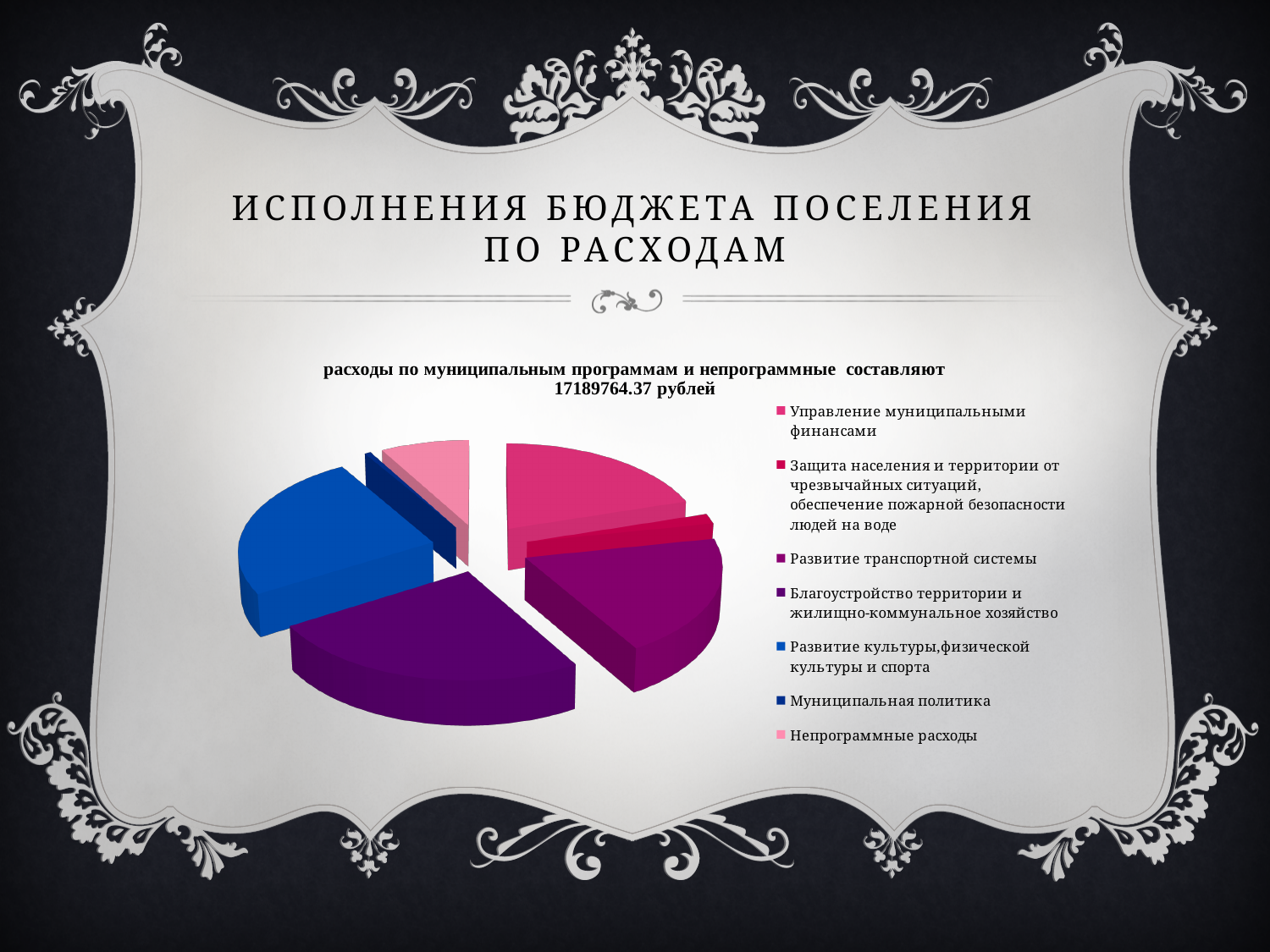
Which slice is larger: "Муниципальная политика" or "Непрограммные расходы"? Непрограммные расходы Which slice is larger: "Управление муниципальными финансами" or "Защита населения и территории от чрезвычайных ситуаций, обеспечение пожарной безопасности людей на воде"? Управление муниципальными финансами How many entries does the chart legend list? 7 According to the chart title, what total amount do the municipal programme and non-programme expenditures make up? 17189764.37 рублей Which slice is larger: "Муниципальная политика" or "Развитие культуры,физической культуры и спорта"? Развитие культуры,физической культуры и спорта What kind of chart is shown on the slide? pie chart How many slices does the pie chart have? 7 What colour is the "Непрограммные расходы" slice in the pie chart? light pink